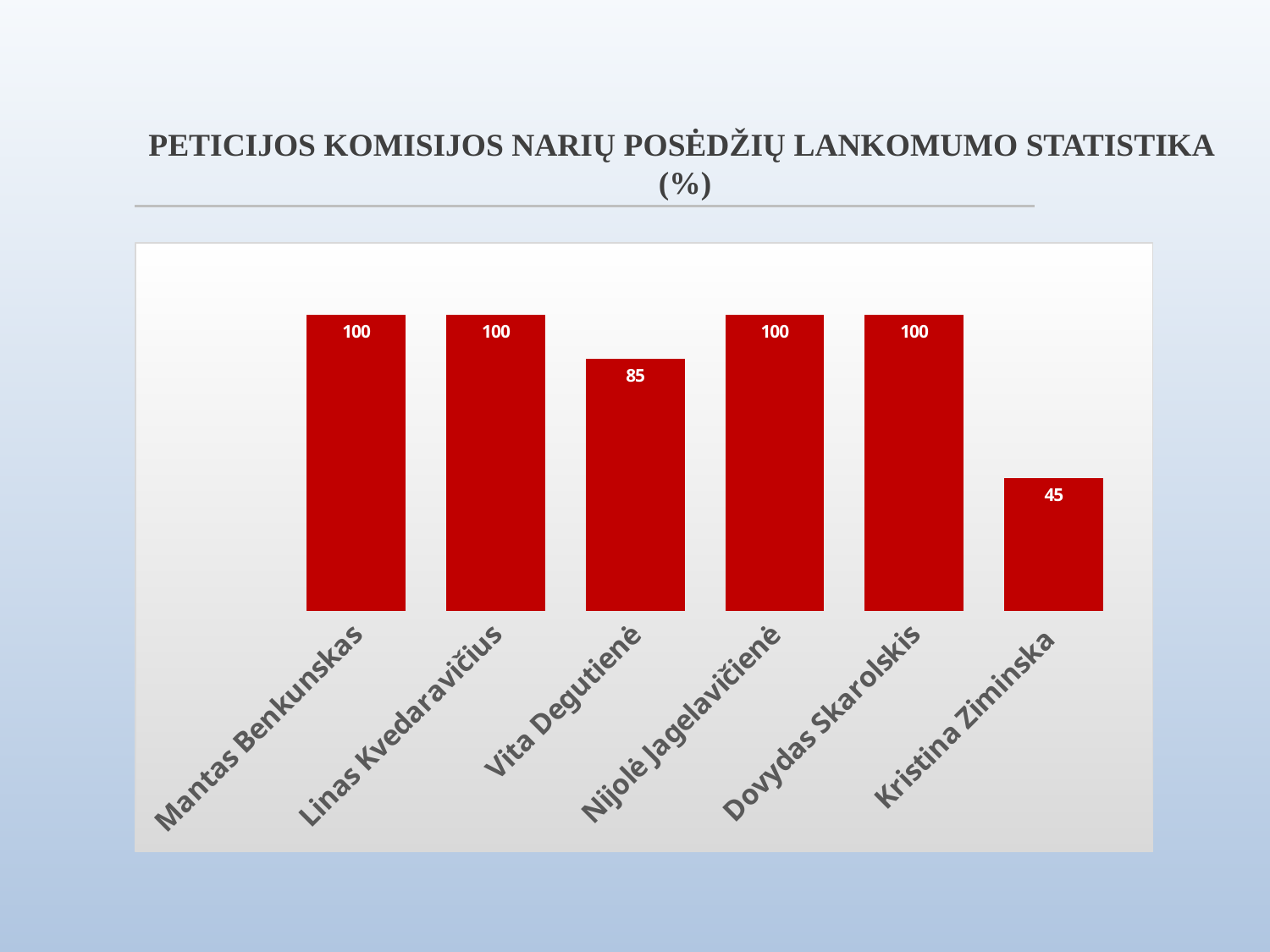
How many categories have a value of 100? 4 Which category has the lowest value? Kristina Ziminska What is the value for Vita Degutienė? 85 What is the difference between the values for Vita Degutienė and Kristina Ziminska? 40 What is the difference between the values for Linas Kvedaravičius and Vita Degutienė? 15 What is the value for Mantas Benkunskas? 100 What is the title of the chart? PETICIJOS KOMISIJOS NARIŲ POSĖDŽIŲ LANKOMUMO STATISTIKA (%) What is the value for Kristina Ziminska? 45 What is the value for Dovydas Skarolskis? 100 How many categories are shown in the chart? 6 Which is larger, the value for Nijolė Jagelavičienė or the value for Vita Degutienė? Nijolė Jagelavičienė What kind of chart is shown on the slide? Bar chart